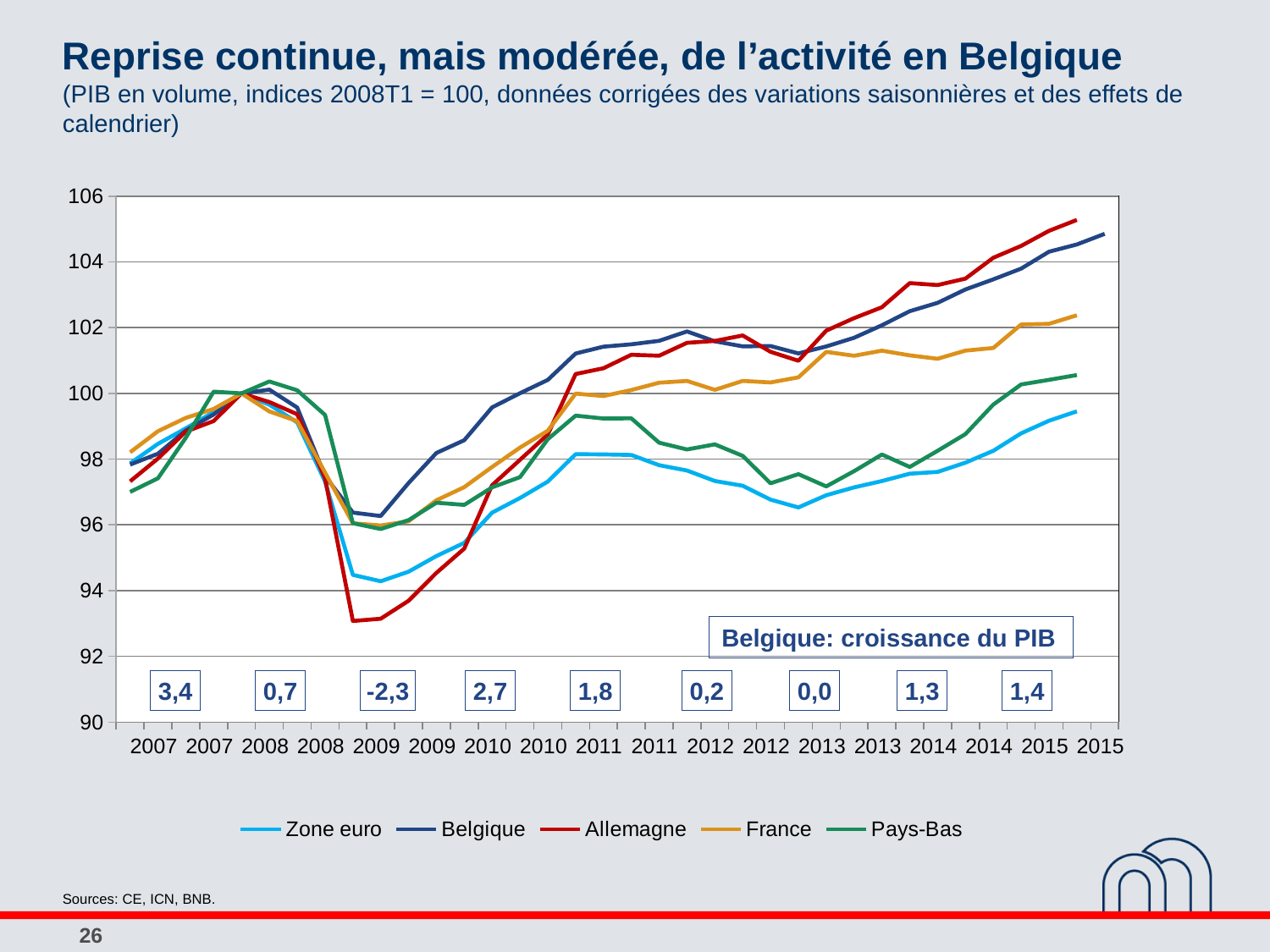
Which series has the lowest index value at the end of 2015? Zone euro According to the 'Belgique: croissance du PIB' boxes, what was Belgian GDP growth in 2013? 0,0 According to the 'Belgique: croissance du PIB' boxes, what was Belgian GDP growth in 2009? -2,3 How many series does the legend list? 5 At the end of 2015, which is higher: France or Pays-Bas? France Which series has the highest index value at the end of 2015? Allemagne In which year do the 'Belgique: croissance du PIB' boxes show the highest growth? 2007 What kind of chart is shown on the slide? line chart Is the lowest value of the Allemagne line in 2009 greater or less than 94? less What is the title of the chart on the slide? Reprise continue, mais modérée, de l'activité en Belgique What is the difference between Belgian GDP growth in 2010 and in 2009, as shown in the boxes? 5,0 In which year do the 'Belgique: croissance du PIB' boxes show the lowest growth? 2009